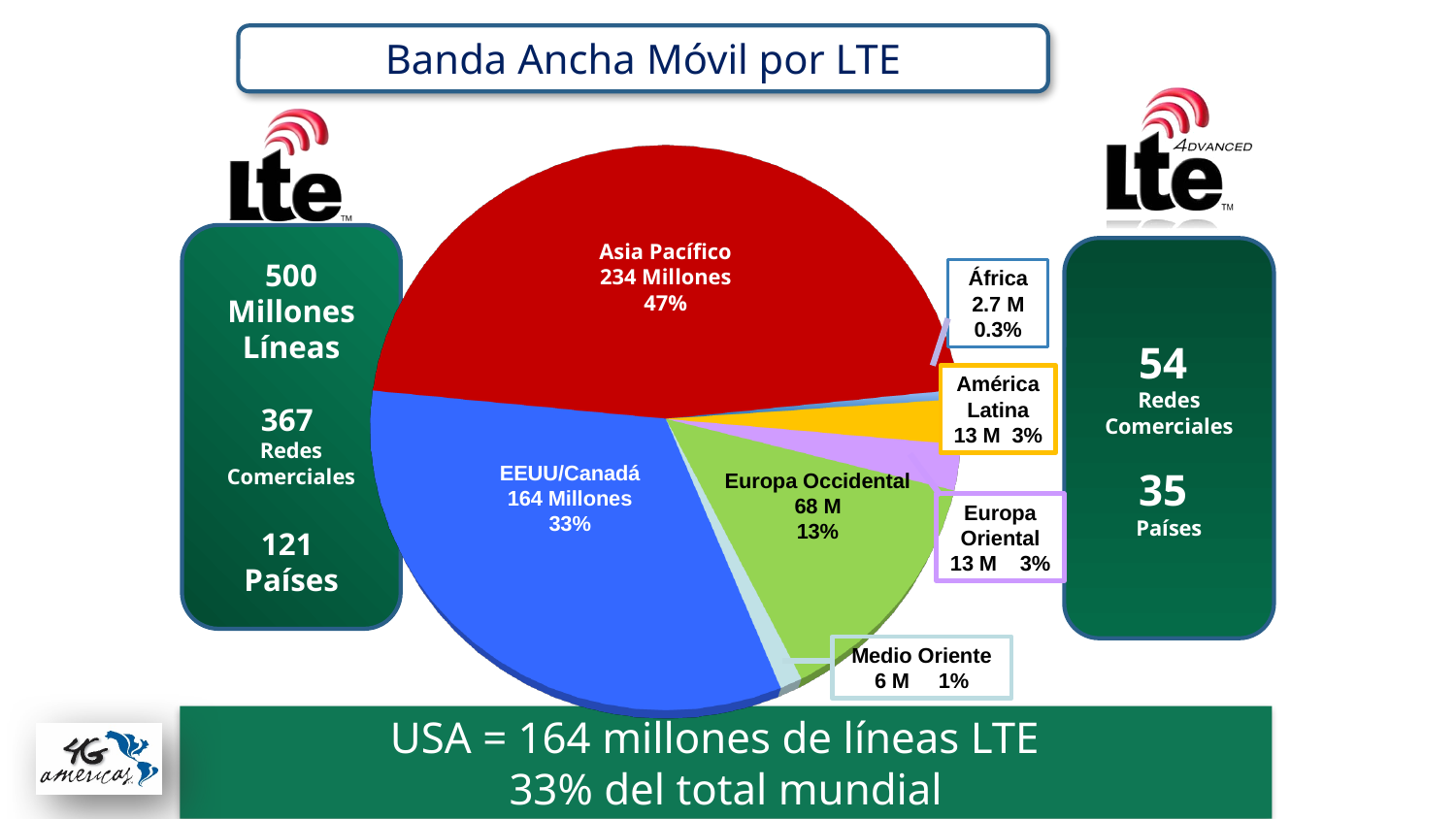
Which region has the smallest slice of the pie? África What share of the pie does Medio Oriente hold? 1% What is the title of the slide containing the pie chart? Banda Ancha Móvil por LTE Which region has the largest slice of the pie? Asia Pacífico What value is shown for EEUU/Canadá? 164 Millones What value is shown for Europa Occidental? 68 M How many slices does the pie chart have? 7 What share of the pie does Asia Pacífico hold? 47% Which is larger, the slice for Europa Occidental or the slice for América Latina? Europa Occidental What is the difference in millions between Asia Pacífico and EEUU/Canadá? 70 Millones What kind of chart is shown on the slide? pie chart What value is shown for África? 2.7 M